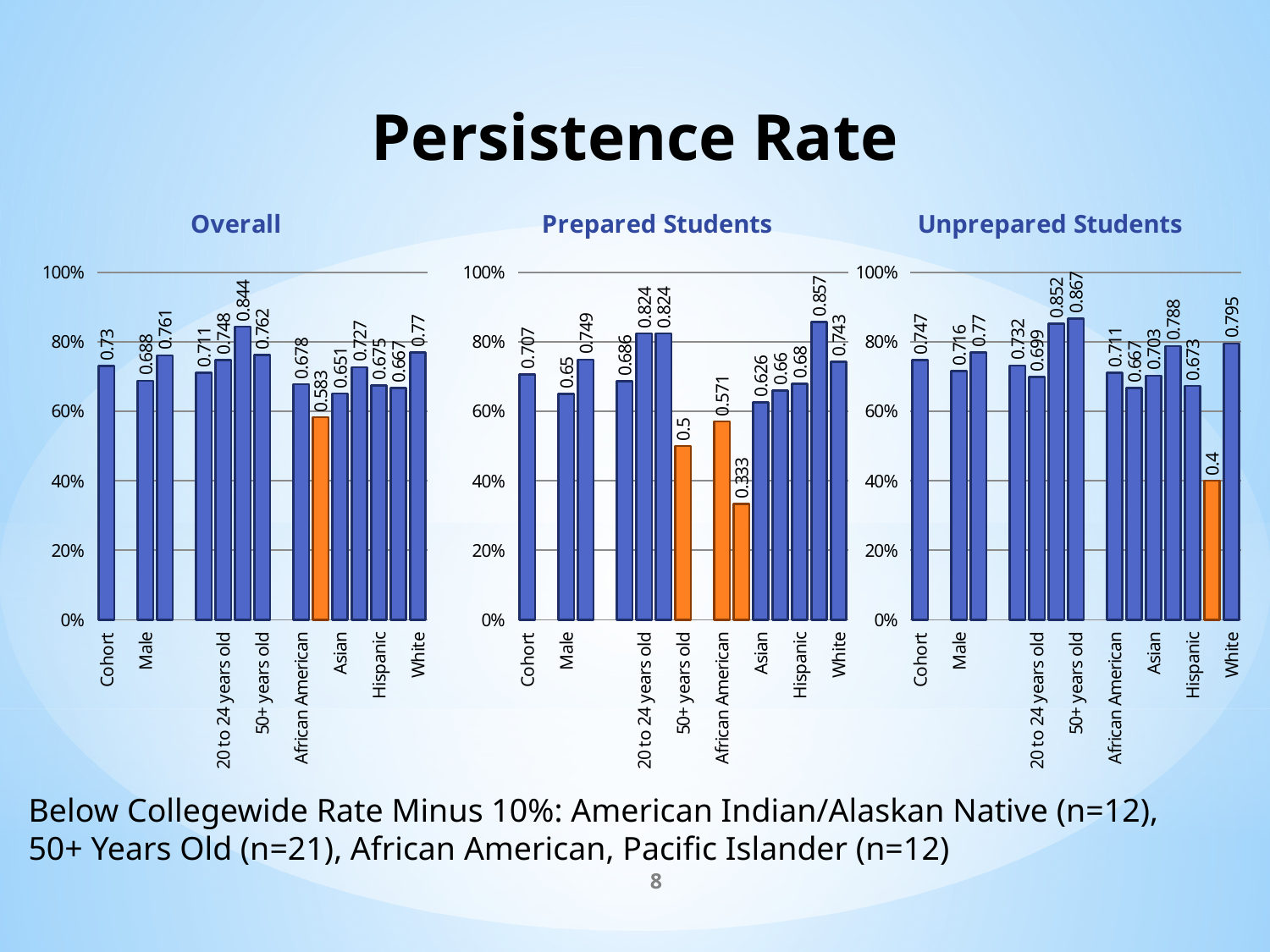
In the Prepared Students chart, how many bars are colored orange? 3 In the Overall chart, what is the persistence rate for the Cohort? 0.73 In the Prepared Students chart, what is the lowest value labeled on any bar? 0.333 How many charts are shown on the slide? 3 In the Overall chart, what is the value for Male? 0.688 In the Overall chart, what is the difference between the Cohort value and the Male value? 0.042 In the Unprepared Students chart, what is the value for 50+ years old? 0.867 In the Unprepared Students chart, which labeled category has the highest value? 50+ years old In the Unprepared Students chart, is the value for Hispanic greater or less than 60%? greater In the Prepared Students chart, which is larger: the value for Hispanic or the value for Asian? Hispanic What type of chart is used for the Overall chart? bar chart In the Prepared Students chart, what is the value for White? 0.743